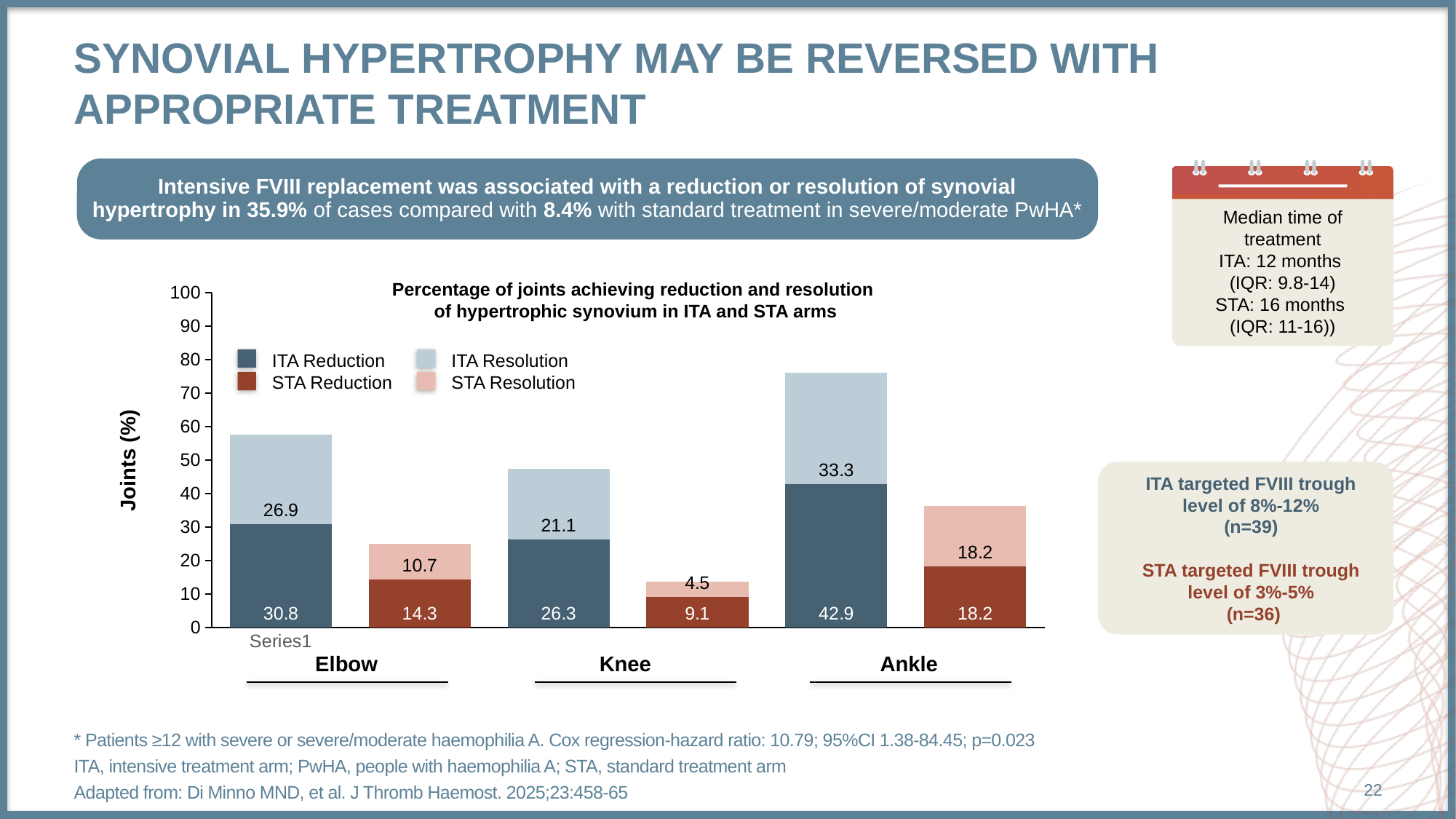
What is the ITA Reduction value for the Ankle joint? 42.9 How many series does the legend list? 4 What is the label of the y axis? Joints (%) What is the total height of the stacked ITA bar for the Ankle joint? 76.2 Which is larger, the STA Reduction value for Elbow or the STA Reduction value for Ankle? Ankle Which joint has the highest ITA Reduction value? Ankle What is the total height of the stacked STA bar for the Elbow joint? 25.0 Which joint has the lowest STA Reduction value? Knee What is the STA Resolution value for the Knee joint? 4.5 What is the ITA Resolution value for the Elbow joint? 26.9 What kind of chart is shown on the slide? Stacked bar chart What is the difference between the ITA Reduction values for Ankle and Elbow? 12.1